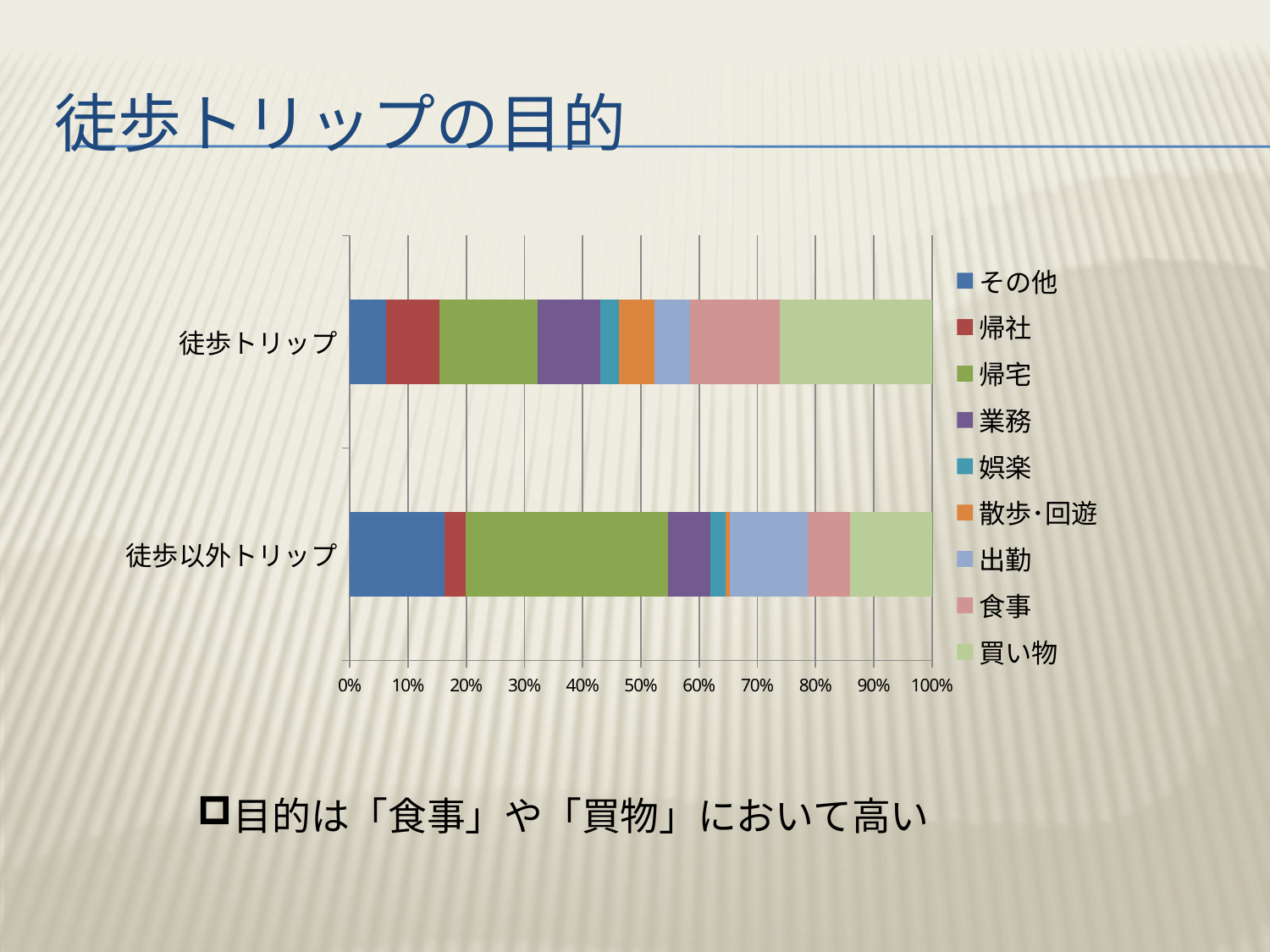
Which series has the largest segment in the 徒歩以外トリップ bar? 帰宅 Is the 食事 share larger for 徒歩トリップ or for 徒歩以外トリップ? 徒歩トリップ How many categories (bars) does the chart show? 2 Which series has the largest segment in the 徒歩トリップ bar? 買い物 What kind of chart is shown on the slide? Stacked bar chart Which legend entry is listed first? その他 Is the 買い物 share larger for 徒歩トリップ or for 徒歩以外トリップ? 徒歩トリップ How many series does the legend list? 9 Is the 出勤 share larger for 徒歩トリップ or for 徒歩以外トリップ? 徒歩以外トリップ What is the title of the slide containing the chart? 徒歩トリップの目的 Which series has the smallest segment in the 徒歩以外トリップ bar? 散歩・回遊